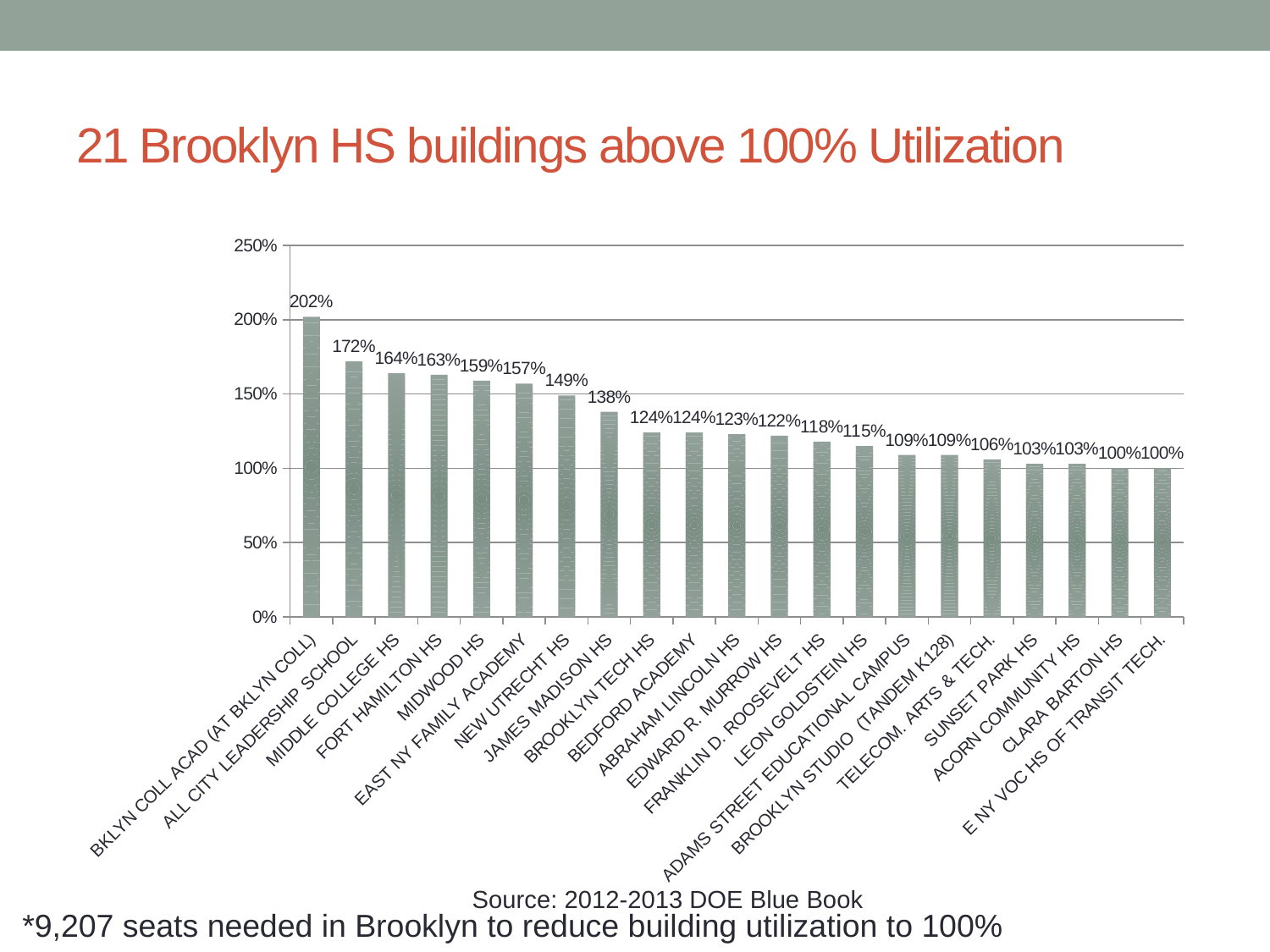
What is the utilization value for JAMES MADISON HS? 138% What is the highest utilization value shown on the chart? 202% What is the utilization value for FORT HAMILTON HS? 163% What is the title of the slide? 21 Brooklyn HS buildings above 100% Utilization What is the utilization value for LEON GOLDSTEIN HS? 115% How many buildings are shown on the chart? 21 What is the difference in utilization between BKLYN COLL ACAD (AT BKLYN COLL) and ALL CITY LEADERSHIP SCHOOL? 30% Which has a higher utilization, MIDWOOD HS or NEW UTRECHT HS? MIDWOOD HS Do the values rise or fall from left to right along the x axis? fall Which building has the highest utilization? BKLYN COLL ACAD (AT BKLYN COLL) Is the value for BROOKLYN TECH HS greater or less than 150%? less What kind of chart is shown on the slide? bar chart